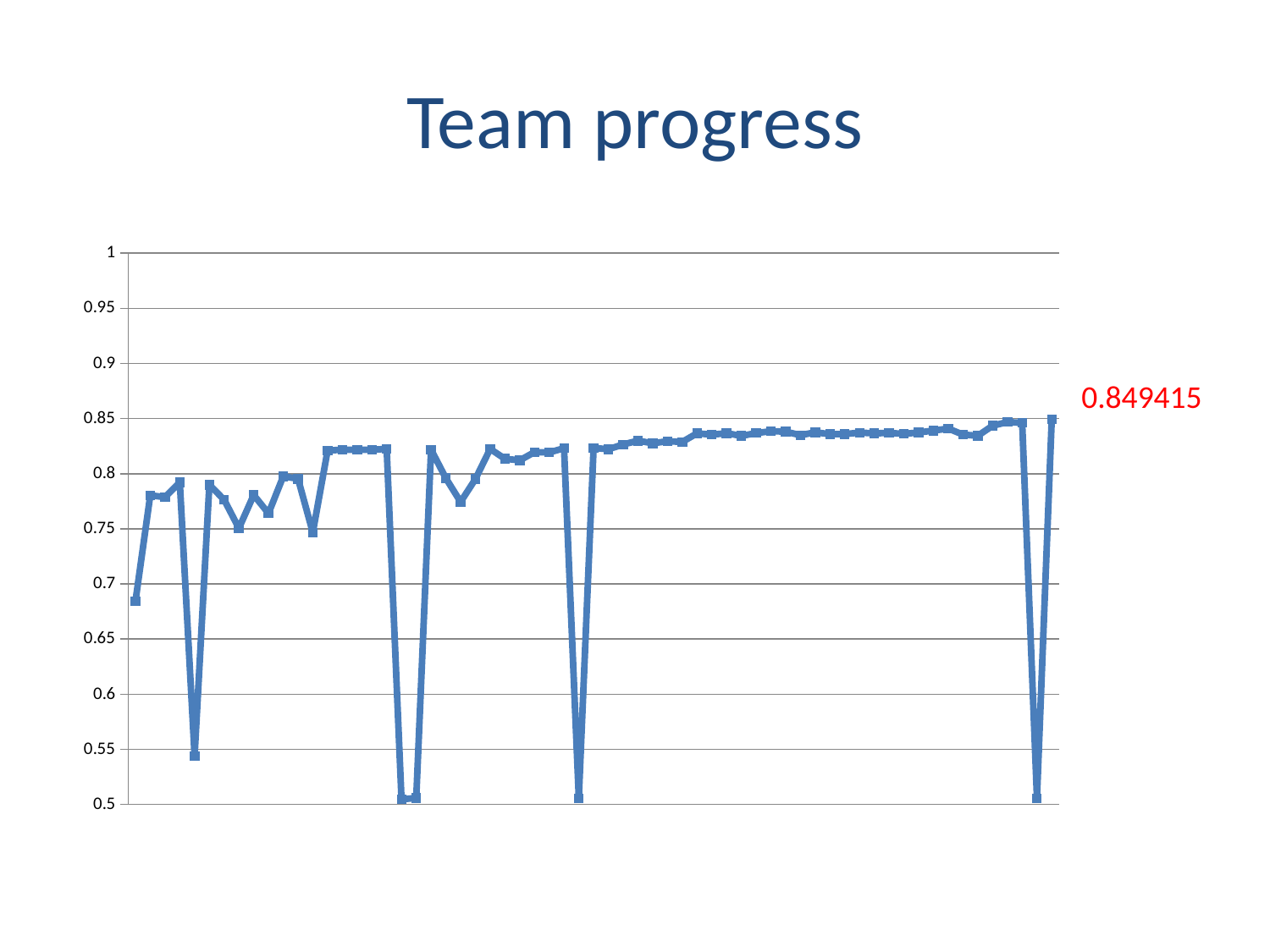
Is the first point of the line greater or less than 0.7? less What are the lowest and highest values shown on the vertical axis? 0.5 and 1 Is the final annotated value of 0.849415 greater or less than 0.85? less What kind of chart is shown on the slide? line chart Is the highest point of the line greater or less than 0.8? greater What value is printed in red next to the end of the line? 0.849415 What is the title of the chart? Team progress Ignoring the sharp dips, does the line generally rise or fall from left to right? rise